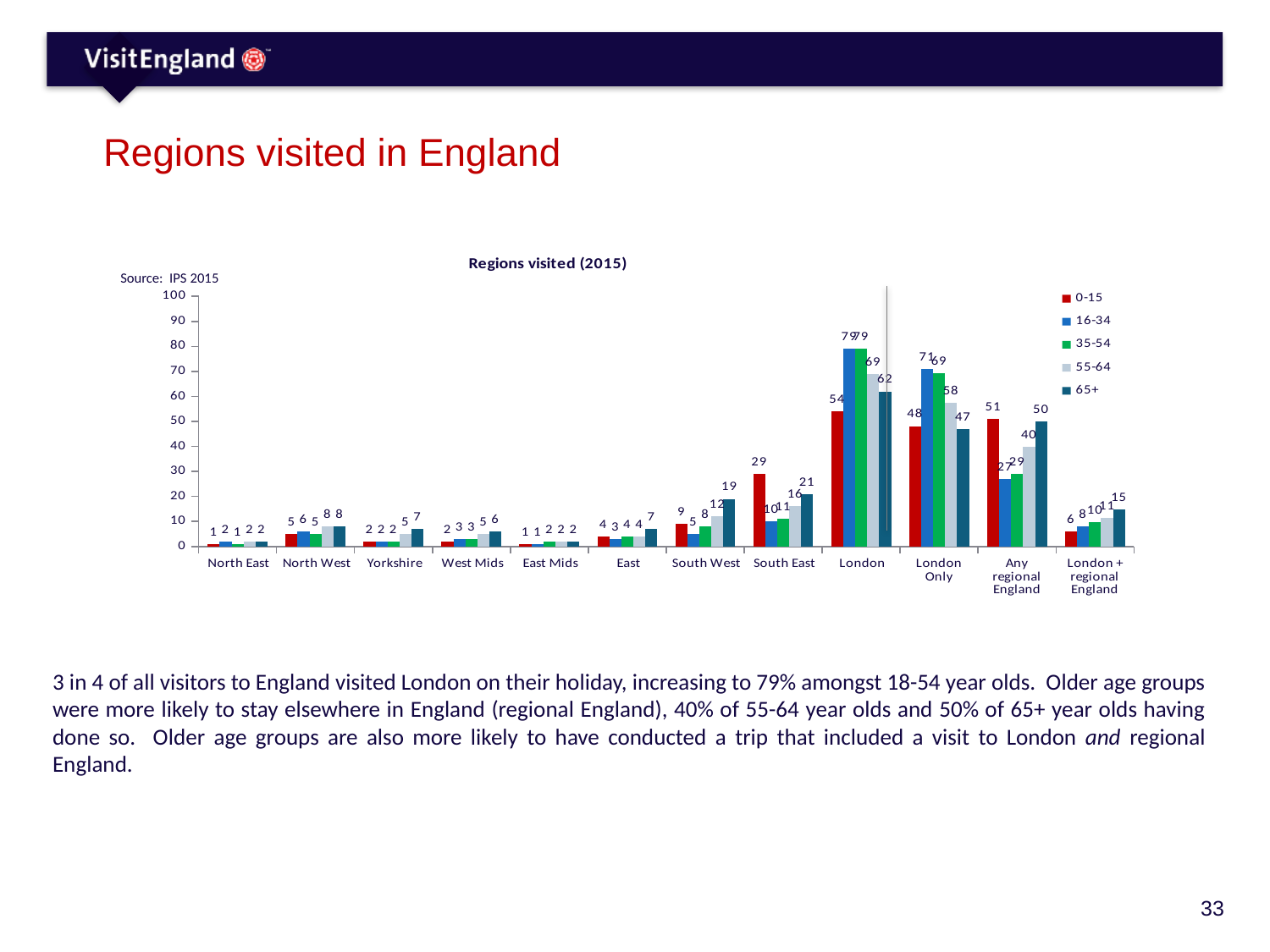
What kind of chart is shown on the slide? Bar chart How many categories are shown on the x axis? 12 What is the value for the 65+ series in the South West category? 19 What is the value for the 16-34 series in the London Only category? 71 What is the value for the 0-15 series in the South East category? 29 How many series does the legend list? 5 In the Any regional England category, which is larger: the 0-15 value or the 16-34 value? 0-15 What is the value for the 55-64 series in the Any regional England category? 40 Which category has the lowest value for the 0-15 series? North East and East Mids (both 1) What is the difference between the 65+ value and the 0-15 value in the London + regional England category? 9 Is the value for the 35-54 series in the London category greater or less than 70? greater Which category has the highest value for the 65+ series? London